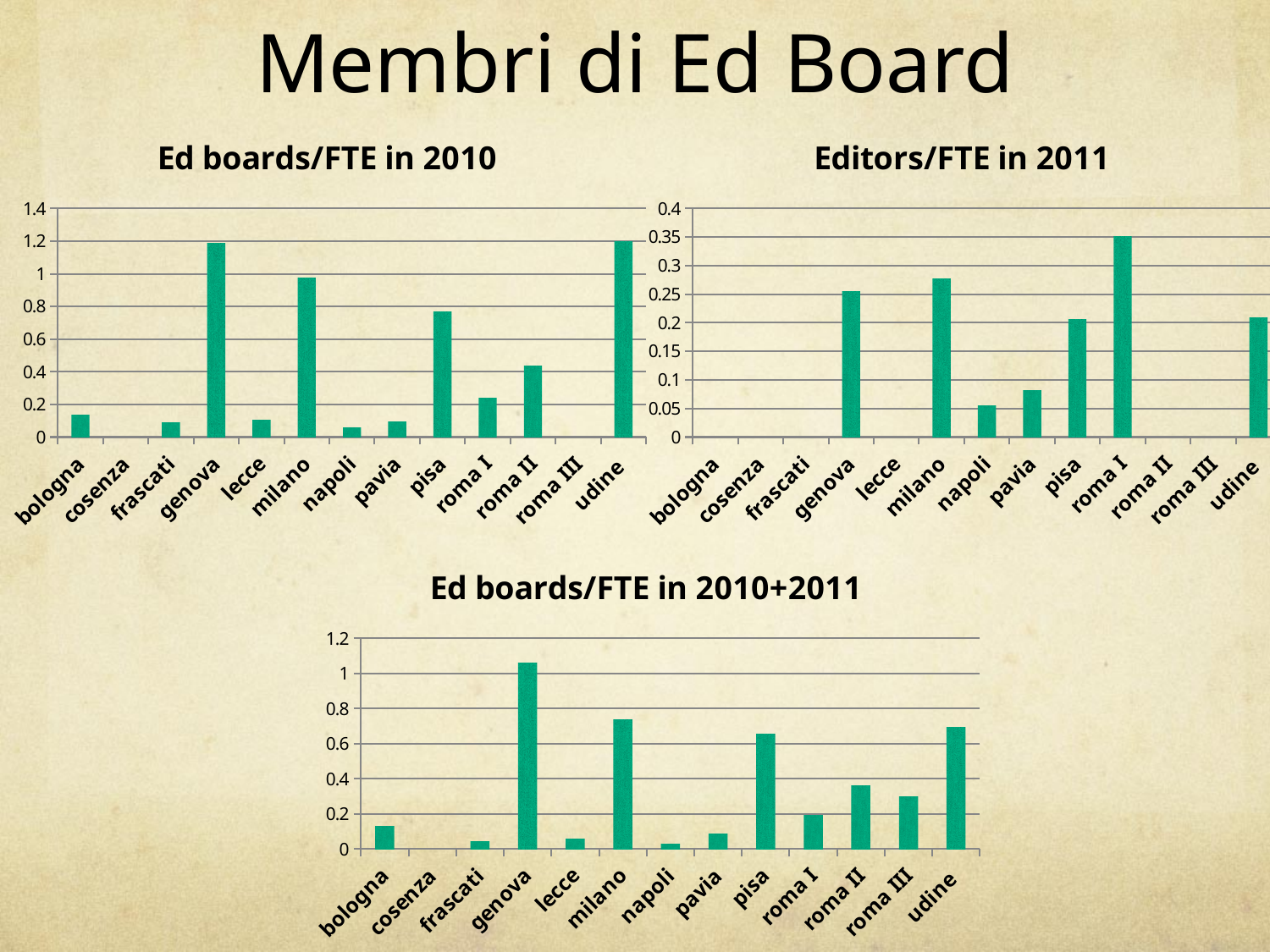
In the 'Ed boards/FTE in 2010+2011' chart, which category has the highest value? genova In the 'Ed boards/FTE in 2010' chart, which is larger, the value for pisa or the value for roma I? pisa What kind of chart is the 'Ed boards/FTE in 2010+2011' chart? bar chart In the 'Editors/FTE in 2011' chart, is the value for roma I greater or less than 0.3? greater In the 'Ed boards/FTE in 2010+2011' chart, is the value for roma II greater or less than 0.4? less In the 'Ed boards/FTE in 2010+2011' chart, is the value for genova greater or less than 1? greater In the 'Editors/FTE in 2011' chart, which category has the highest value? roma I In the 'Ed boards/FTE in 2010+2011' chart, which is larger, the value for milano or the value for pisa? milano How many categories are shown on the x axis of the 'Editors/FTE in 2011' chart? 13